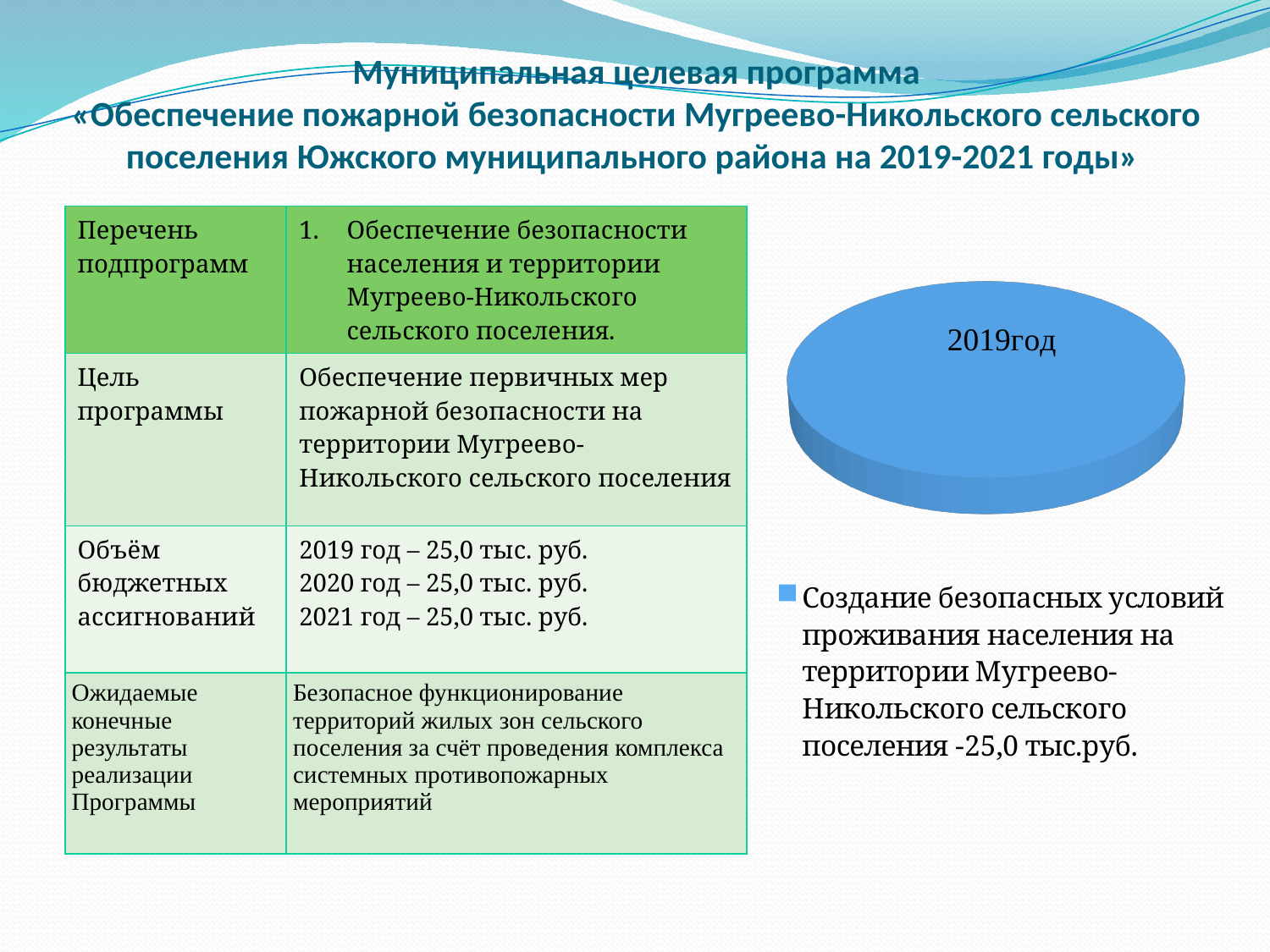
What colour is the slice of the pie chart? blue Is the pie chart drawn in 3D or flat 2D? 3D What share of the pie does the slice labelled 2019год take up? 100% What kind of chart is shown on the right side of the slide? pie chart What label is printed on the pie chart's slice? 2019год How many slices does the pie chart contain? 1